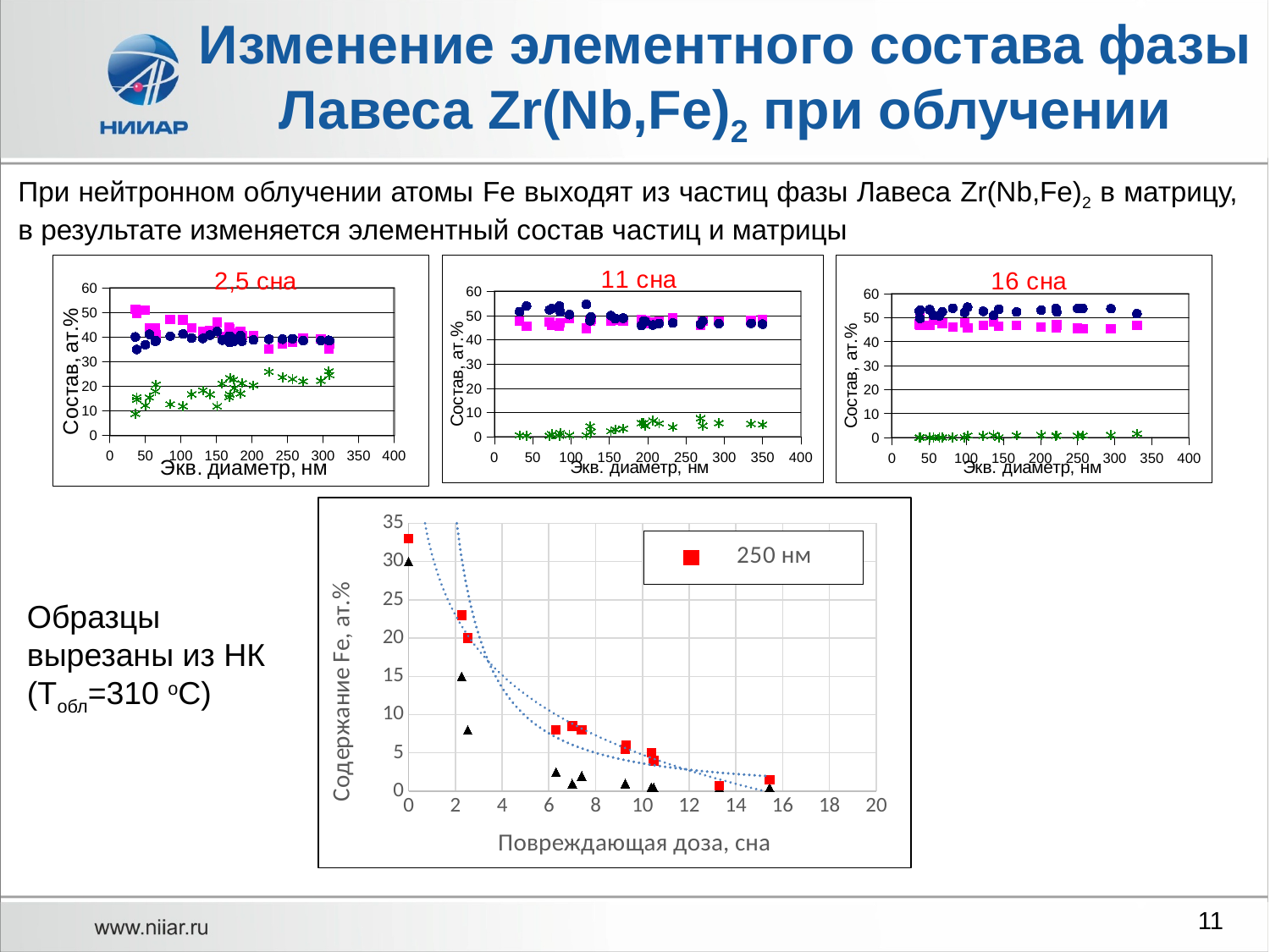
What is the y-axis title of the bottom chart? Содержание Fe, ат.% What is the legend entry shown in the bottom chart? 250 нм What kind of chart is the bottom chart with the x axis 'Повреждающая доза, сна'? scatter chart In the bottom chart, do the red square values rise or fall as the damaging dose increases along the x axis? fall In the bottom chart, is the red square value at dose 14 greater or less than 5? less In the chart titled '2,5 сна', are the green star values greater or less than 30? less In the chart titled '11 сна', are the blue circle values greater or less than 40? greater In the chart titled '2,5 сна', which series has the lowest values: the blue circles, the pink squares, or the green stars? green stars How many small charts with the x axis 'Экв. диаметр, нм' are shown in the top row of the slide? 3